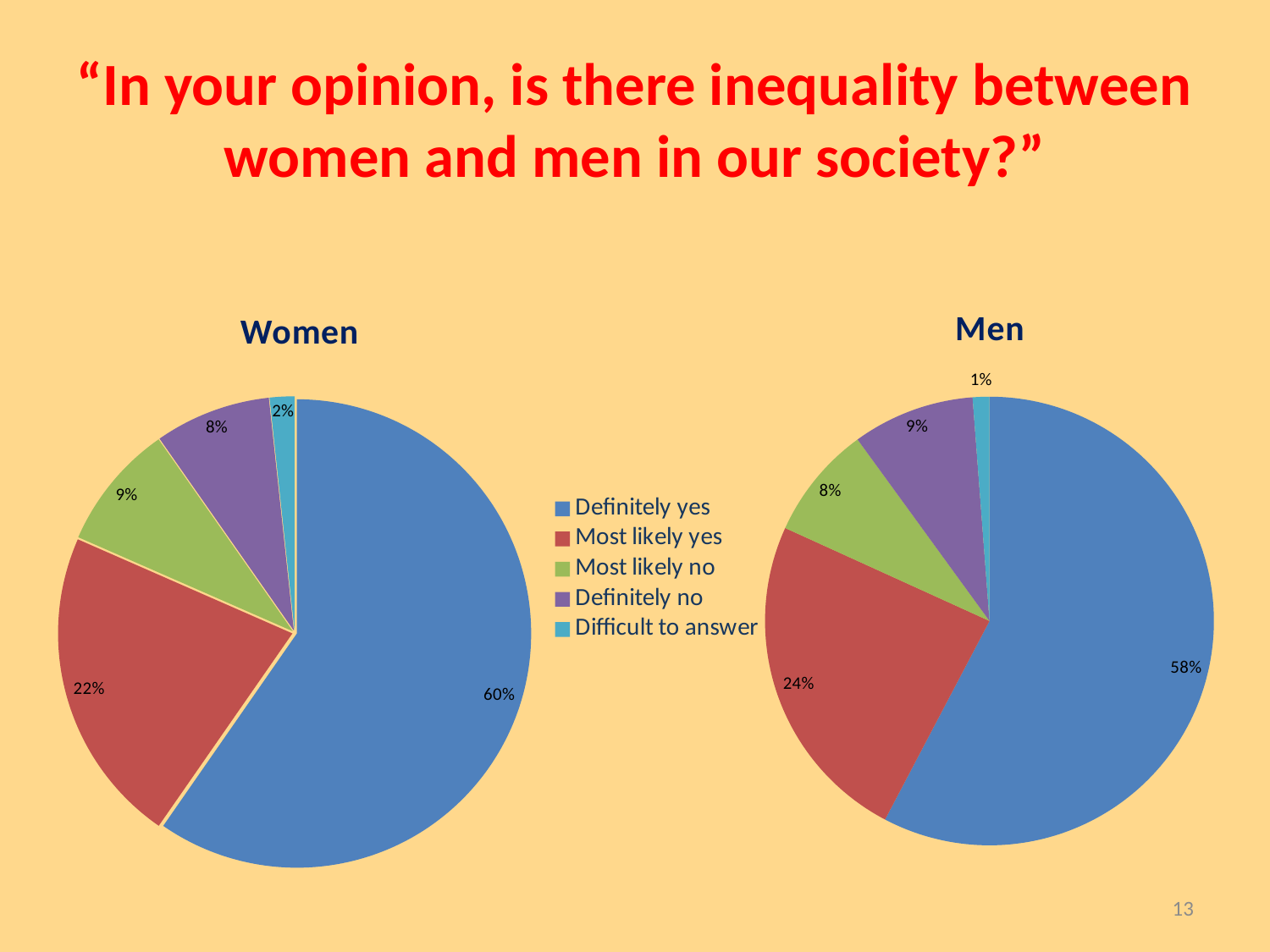
In the Men pie chart, which response has the smallest slice? Difficult to answer What type of chart is used for the Women and Men data on this slide? Pie chart In the Men pie chart, what share of respondents answered "Most likely yes"? 24% In the Women pie chart, which response has the largest slice? Definitely yes In the Women pie chart, what share of respondents answered "Definitely yes"? 60% In the Women pie chart, what is the difference between the "Definitely yes" and "Most likely yes" shares? 38% In the Men pie chart, what share of respondents answered "Definitely no"? 9% Which colour represents "Most likely no" in the legend? Green How many response categories does the legend list? 5 In the Women pie chart, what share of respondents answered "Difficult to answer"? 2% In the Men pie chart, which is larger: "Most likely no" or "Definitely no"? Definitely no Is the "Definitely yes" share larger in the Women pie chart or the Men pie chart? Women